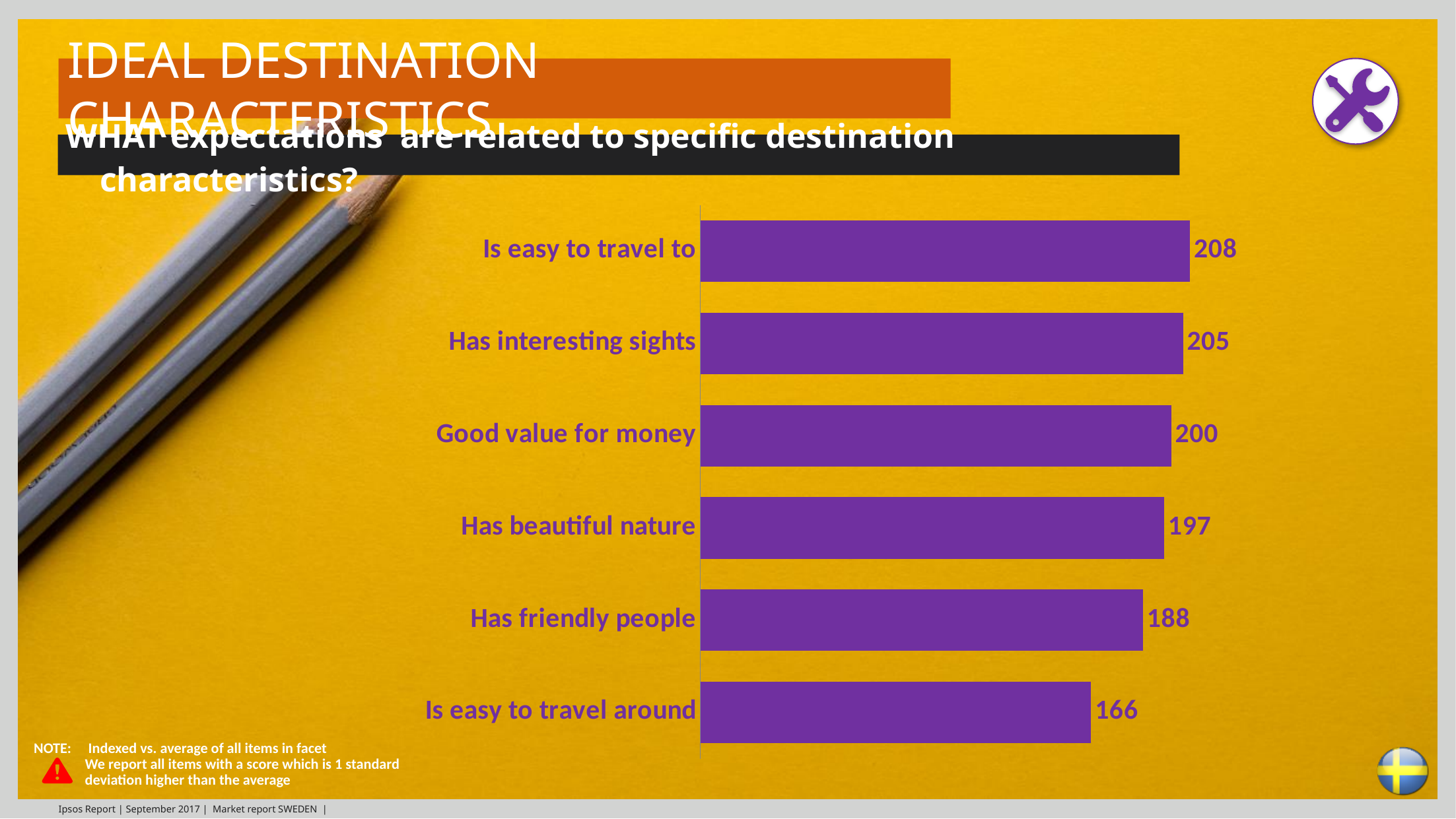
Do the values rise or fall going from the top bar to the bottom bar? Fall What kind of chart is shown on the slide? Bar chart Which category has the lowest value? Is easy to travel around What is the value for 'Is easy to travel around'? 166 What is the value for 'Has beautiful nature'? 197 What is the value for 'Is easy to travel to'? 208 How many categories are shown in the chart? 6 What is the difference between 'Has interesting sights' and 'Has friendly people'? 17 What is the difference between 'Good value for money' and 'Is easy to travel around'? 34 Which is larger: 'Has friendly people' or 'Has beautiful nature'? Has beautiful nature Which category has the highest value? Is easy to travel to What colour are the bars in the chart? Purple